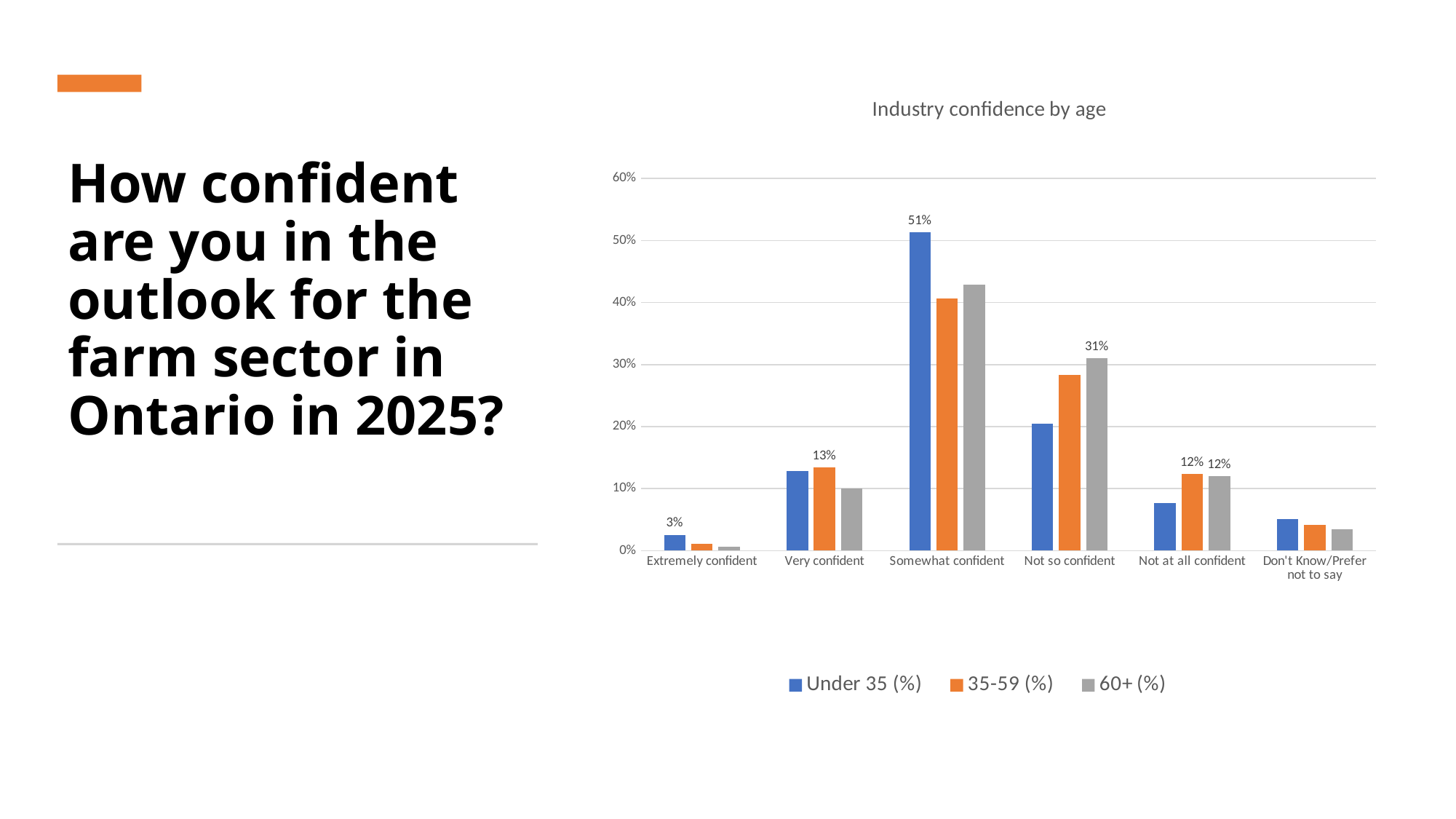
Is the value for Under 35 (%) in the Not so confident category greater or less than 30%? less What is the difference between the Under 35 (%) values for Somewhat confident and Extremely confident? 48 percentage points What is the value for Under 35 (%) in the Somewhat confident category? 51% How many series does the legend list? 3 What is the value for 60+ (%) in the Not so confident category? 31% How many categories are shown on the x axis? 6 What is the value for 35-59 (%) in the Very confident category? 13% What is the title of the chart? Industry confidence by age Which category has the highest value for the Under 35 (%) series? Somewhat confident What is the value for Under 35 (%) in the Extremely confident category? 3% Is the value for 60+ (%) in the Somewhat confident category greater or less than 40%? greater Which series has the highest value in the Not so confident category? 60+ (%)